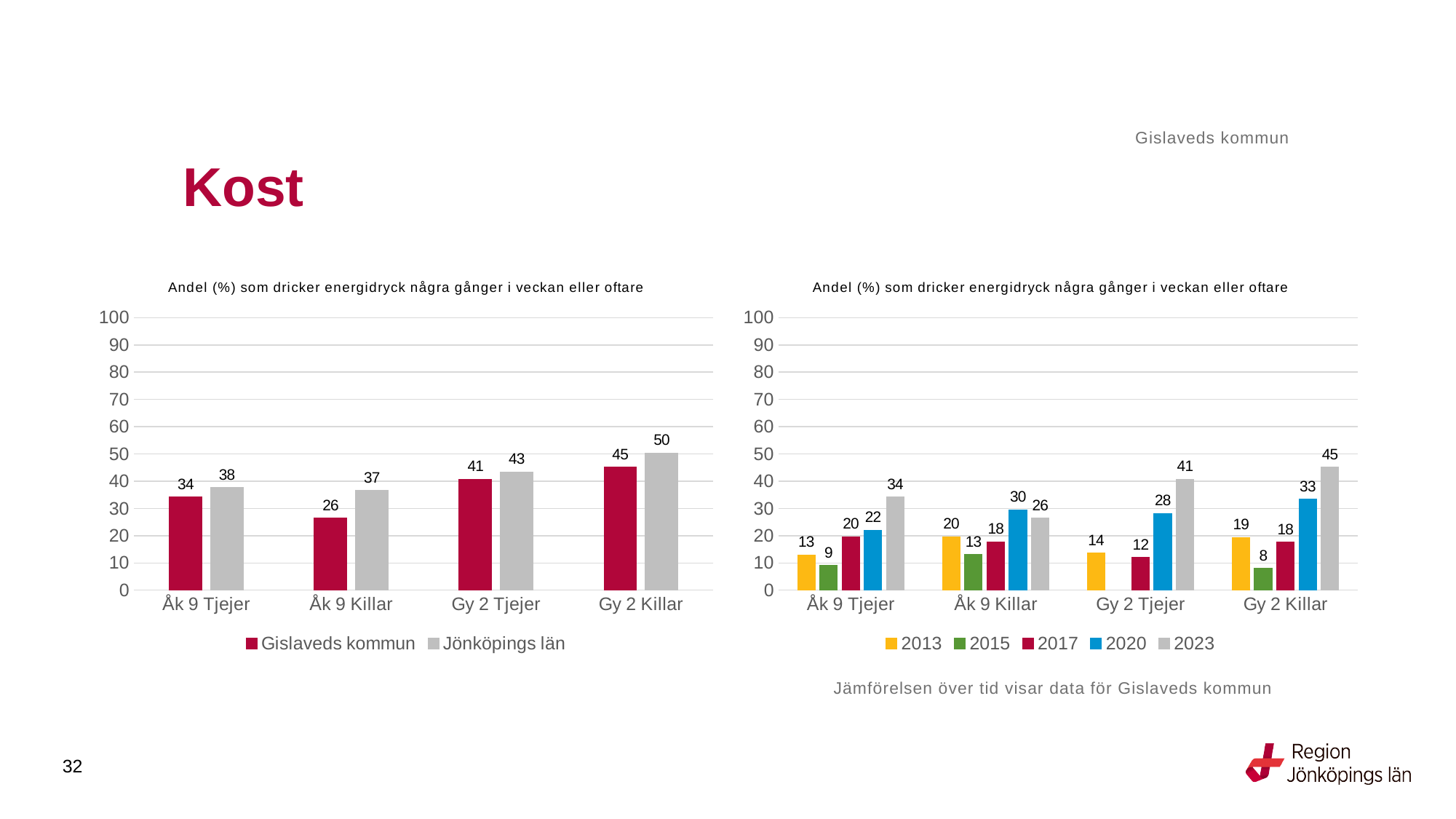
In the right chart, what is the value for 2020 for Åk 9 Killar? 30 What type of chart is the left chart? Bar chart In the left chart, what is the value for Jönköpings län for Gy 2 Killar? 50 In the left chart, how many series does the legend list? 2 In the right chart, which year has the lowest value for Åk 9 Tjejer? 2015 In the left chart, what is the value for Gislaveds kommun for Åk 9 Killar? 26 In the left chart, what is the difference between Jönköpings län and Gislaveds kommun for Åk 9 Killar? 11 In the right chart, is the 2023 value for Gy 2 Tjejer larger or smaller than the 2020 value? larger In the right chart, how many series does the legend list? 5 In the right chart, what is the difference between the 2023 and 2013 values for Gy 2 Killar? 26 In the left chart, which category has the highest value for Gislaveds kommun? Gy 2 Killar In the right chart, what is the value for 2015 for Gy 2 Killar? 8